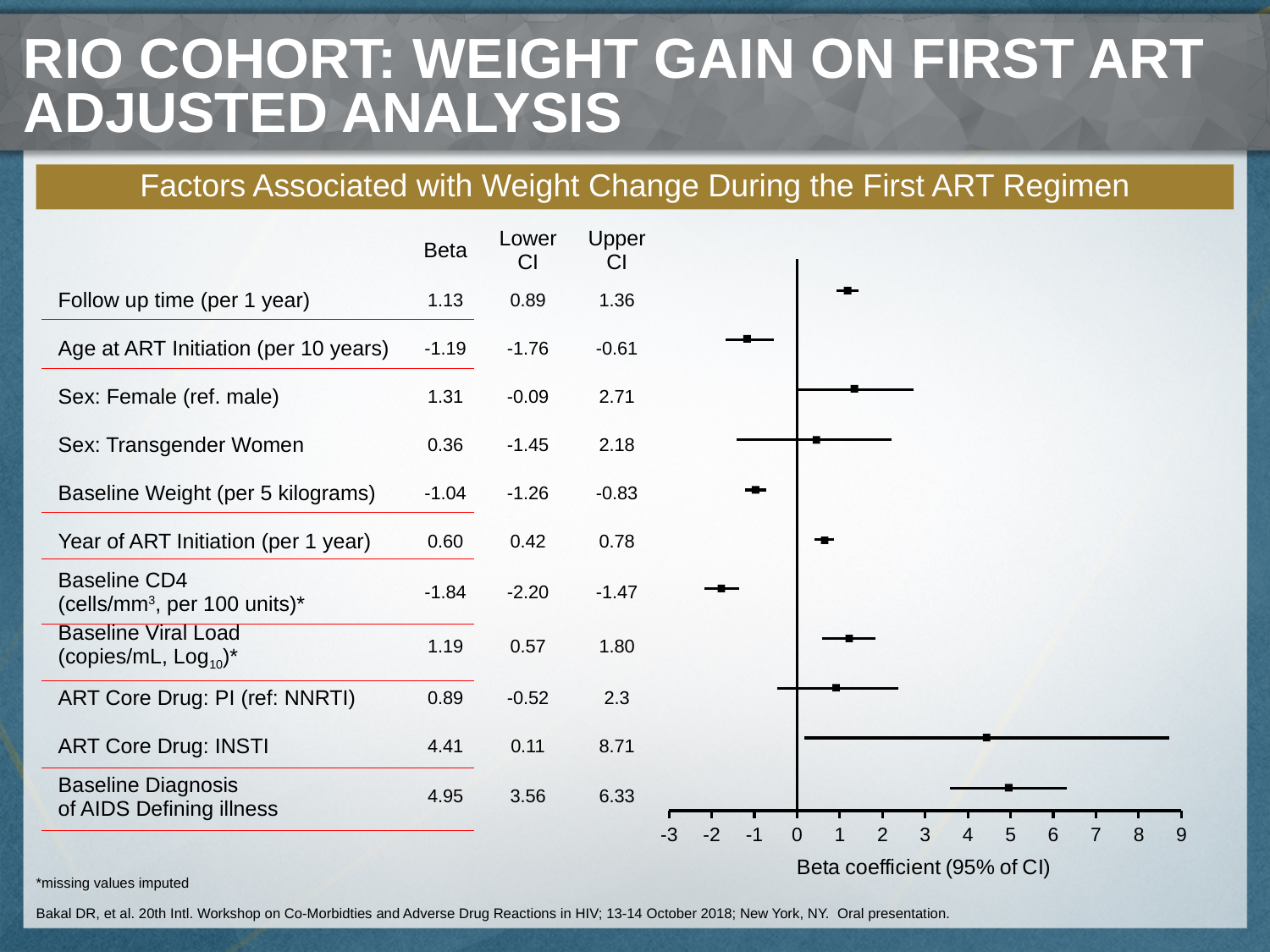
Which has a larger Beta coefficient, Sex: Female (ref. male) or Sex: Transgender Women? Sex: Female (ref. male) How many factors are plotted in the chart? 11 Which factor has the highest Beta coefficient? Baseline Diagnosis of AIDS Defining illness What is the Beta value for Follow up time (per 1 year)? 1.13 Which factor has the lowest Beta coefficient? Baseline CD4 (cells/mm³, per 100 units) What is the label of the x axis of the chart? Beta coefficient (95% of CI) What is the difference in Beta between Baseline Diagnosis of AIDS Defining illness and ART Core Drug: INSTI? 0.54 What kind of chart is shown on the slide? Forest plot Is the Beta coefficient for ART Core Drug: INSTI greater or less than 4? greater What is the Upper CI for ART Core Drug: INSTI? 8.71 What is the difference between the Upper CI and Lower CI for ART Core Drug: INSTI? 8.60 What is the Lower CI for Baseline CD4 (cells/mm³, per 100 units)? -2.20